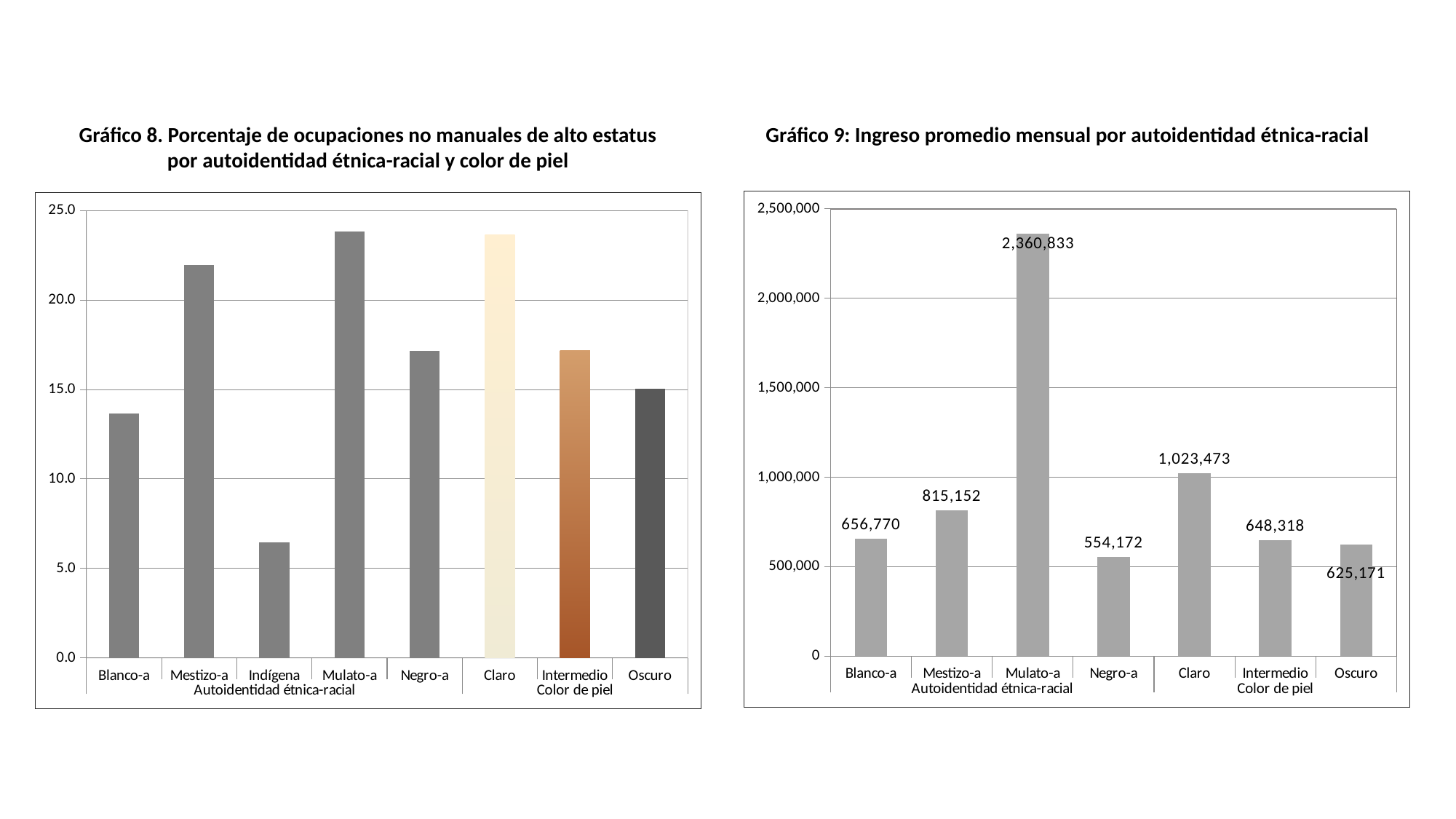
In Gráfico 9, what is the value for Mulato-a? 2,360,833 In Gráfico 8, how many categories are plotted? 8 In Gráfico 9, what is the difference between the values for Claro and Intermedio? 375,155 In Gráfico 8, which category has the lowest value? Indígena What kind of chart is Gráfico 8? Bar chart In Gráfico 9, how many categories are plotted? 7 In Gráfico 8, is the value for Indígena greater or less than 10.0? less In Gráfico 9, what is the value for Intermedio? 648,318 In Gráfico 8, is the value for Mestizo-a greater or less than 20.0? greater In Gráfico 9, which category has the lowest value? Negro-a In Gráfico 9, which is larger, the value for Blanco-a or the value for Intermedio? Blanco-a In Gráfico 9, which category has the highest value? Mulato-a